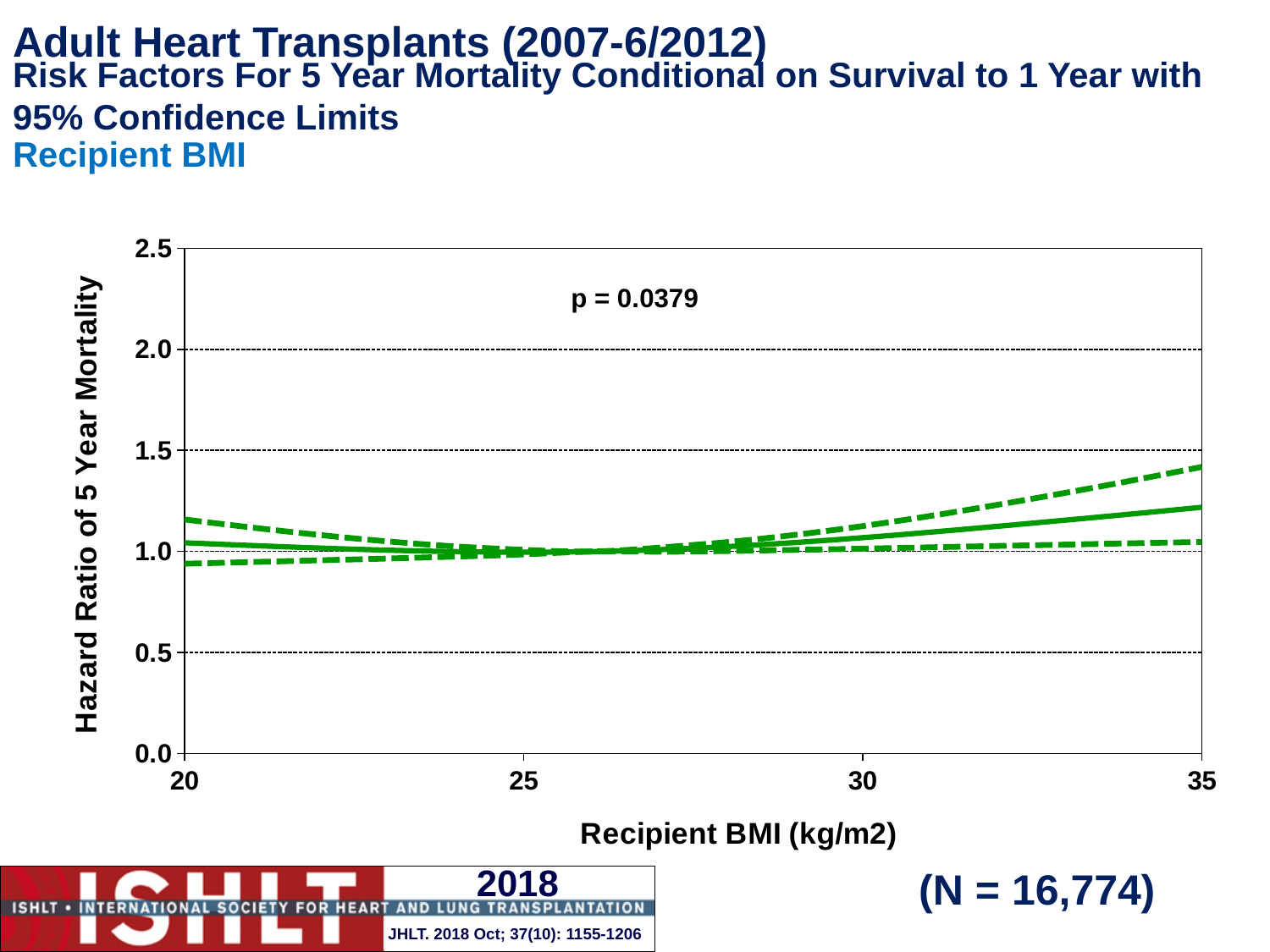
Between a recipient BMI of 30 and 35, does the solid hazard ratio line rise or fall? rise What sample size (N) is shown on the slide? N = 16,774 What kind of chart is shown on the slide? line chart Between a recipient BMI of 20 and 25, does the solid hazard ratio line rise or fall? fall Is the hazard ratio (solid line) at a recipient BMI of 25 greater or less than 1.5? less Is the hazard ratio (solid line) at a recipient BMI of 35 greater or less than 1.5? less Is the upper confidence limit (upper dashed line) at a recipient BMI of 35 greater or less than 2.0? less Is the hazard ratio (solid line) higher at a recipient BMI of 35 or at a recipient BMI of 20? 35 How many lines are plotted on the chart (solid and dashed)? 3 What p-value is printed on the chart? p = 0.0379